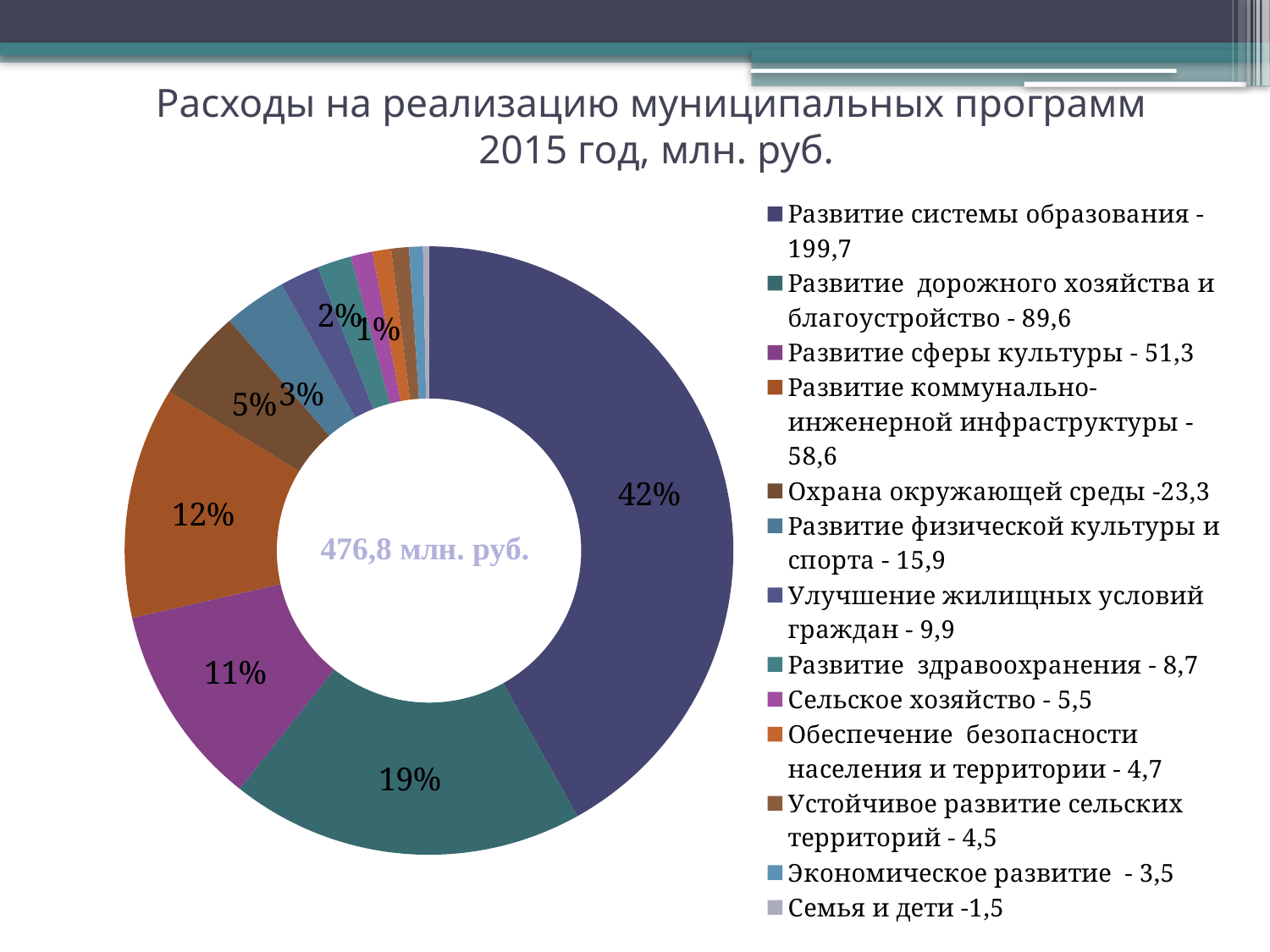
What kind of chart is shown on the slide? doughnut chart What share of the chart does Развитие дорожного хозяйства и благоустройство take? 19% How many categories does the legend list? 13 Which category has the largest share of the chart? Развитие системы образования What is the value for Охрана окружающей среды? 23,3 What is the value for Развитие системы образования? 199,7 Which category has the smallest value? Семья и дети What is the value for Экономическое развитие? 3,5 What is the value for Развитие дорожного хозяйства и благоустройство? 89,6 Which is larger: Развитие сферы культуры or Развитие коммунально-инженерной инфраструктуры? Развитие коммунально-инженерной инфраструктуры What is the difference between the values for Развитие системы образования and Развитие дорожного хозяйства и благоустройство? 110,1 What share of the chart does Развитие системы образования take? 42%